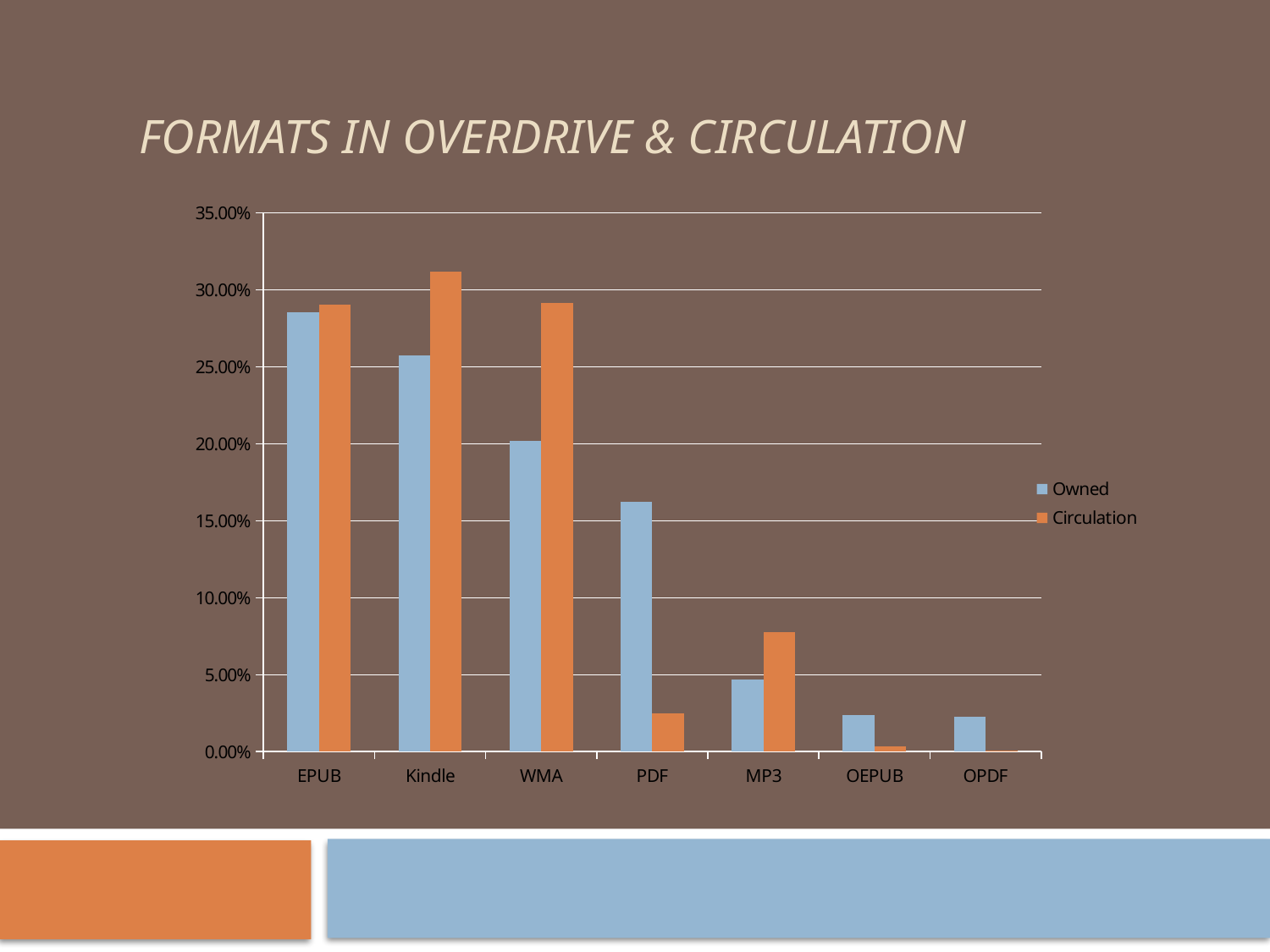
Is the Owned value for EPUB greater or less than 25.00%? greater What kind of chart is shown on the slide? bar chart For Kindle, which is larger: the Owned value or the Circulation value? Circulation For PDF, which is larger: the Owned value or the Circulation value? Owned Is the Circulation value for MP3 greater or less than 5.00%? greater What is the title of the chart? FORMATS IN OVERDRIVE & CIRCULATION How many series does the legend list? 2 Is the Circulation value for PDF greater or less than 5.00%? less Which format has the highest Circulation value? Kindle How many format categories are shown on the x axis? 7 Which format has the highest Owned value? EPUB Do the Owned values rise or fall moving from EPUB to OPDF along the x axis? fall